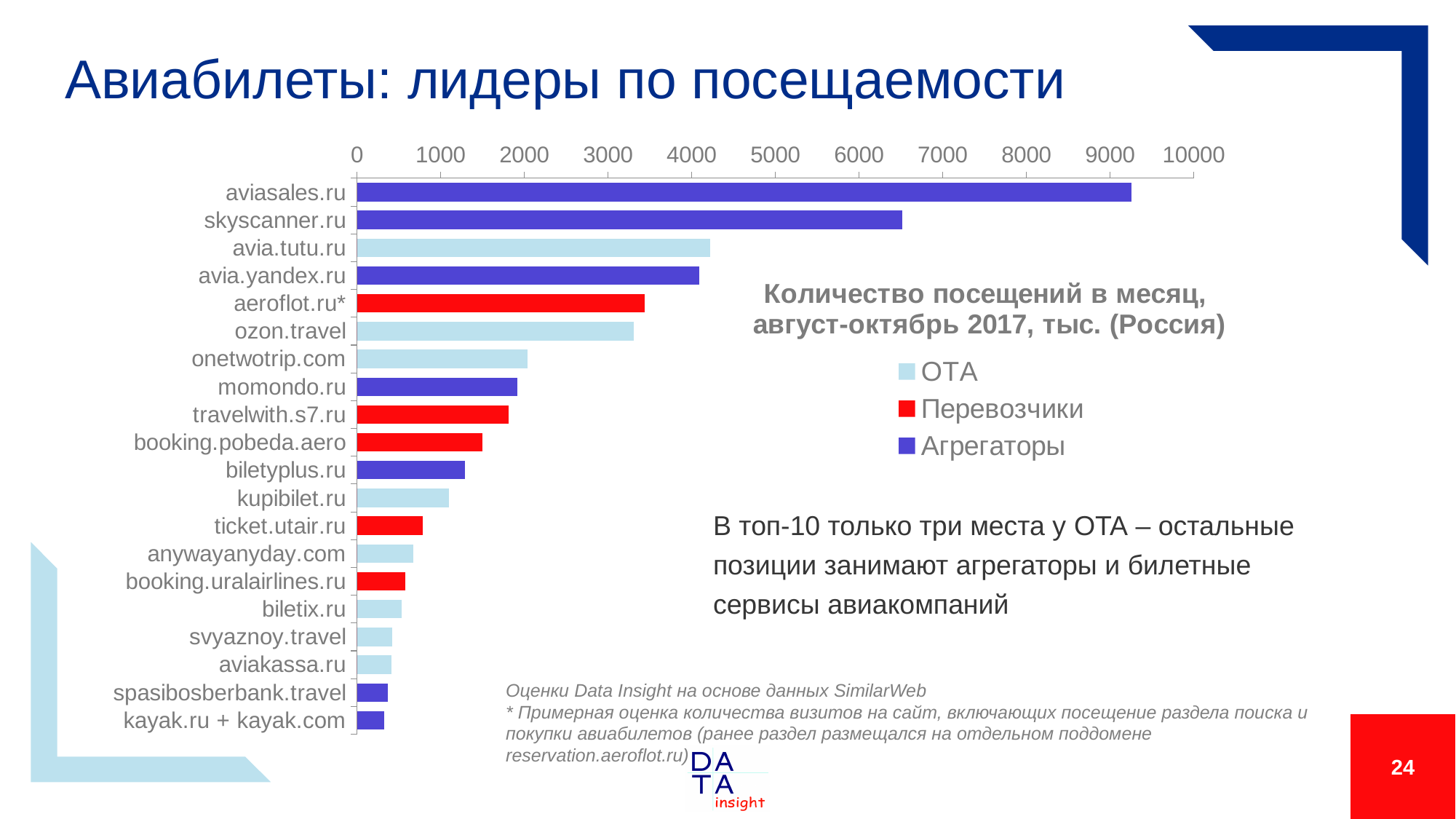
How many series does the legend list? 3 Is the value for aviasales.ru greater or less than 9000? greater What kind of chart is shown on the slide? bar chart Is the value for skyscanner.ru greater or less than 6000? greater Which website has the highest number of monthly visits? aviasales.ru How many websites (bars) are shown in the chart? 20 Which colour represents the series Перевозчики in the legend? red Is the value for ticket.utair.ru greater or less than 1000? less Which has more monthly visits, skyscanner.ru or avia.tutu.ru? skyscanner.ru Which has more monthly visits, booking.pobeda.aero or biletyplus.ru? booking.pobeda.aero